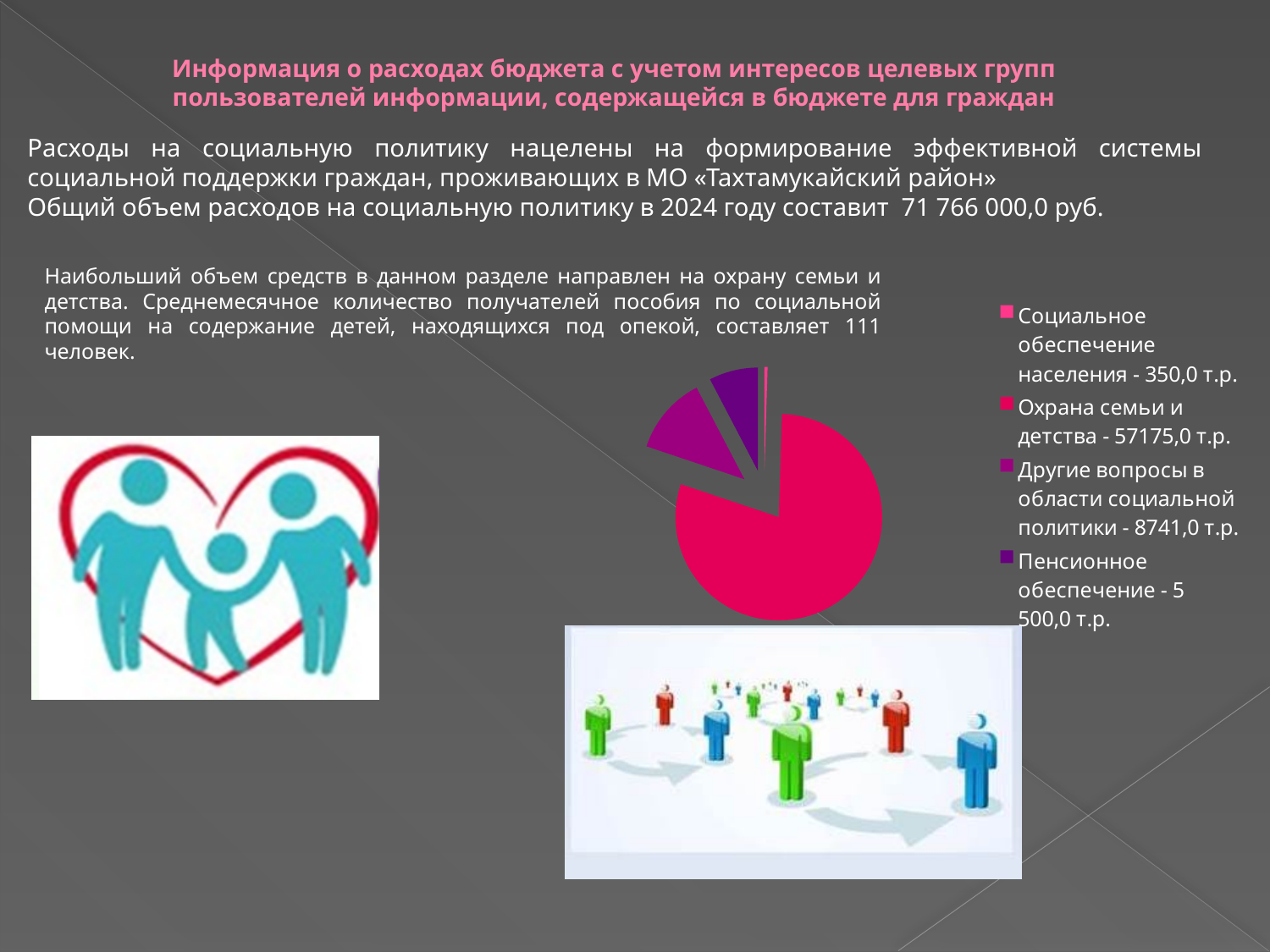
What is the value for Социальное обеспечение населения in the pie chart? 350,0 т.р. How many slices does the pie chart have? 4 What is the value for Пенсионное обеспечение in the pie chart? 5 500,0 т.р. What is the value for Другие вопросы в области социальной политики in the pie chart? 8741,0 т.р. How many entries does the legend of the pie chart list? 4 Which is larger in the pie chart: Другие вопросы в области социальной политики or Пенсионное обеспечение? Другие вопросы в области социальной политики What is the value for Охрана семьи и детства in the pie chart? 57175,0 т.р. Which category has the smallest slice in the pie chart? Социальное обеспечение населения What is the difference between Охрана семьи и детства and Другие вопросы в области социальной политики in the pie chart? 48434,0 т.р. Which category has the largest slice in the pie chart? Охрана семьи и детства What kind of chart is shown on the slide? Pie chart What is the total of all four values shown in the pie chart legend? 71766,0 т.р.